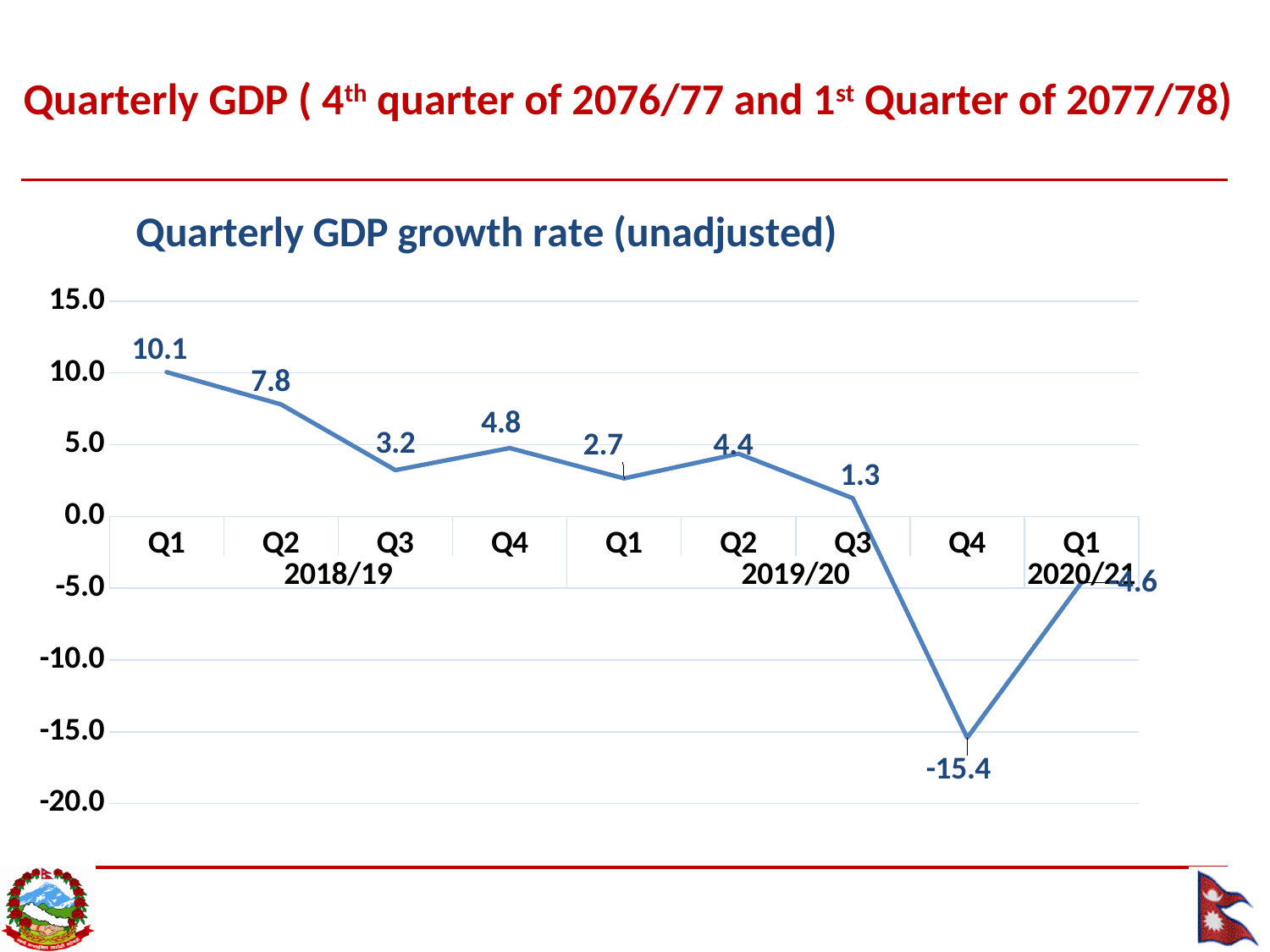
What is the quarterly GDP growth rate for Q3 of 2018/19? 3.2 Which quarter has the highest GDP growth rate? Q1 2018/19 Which quarter has the lowest GDP growth rate? Q4 2019/20 What is the difference between the GDP growth rate in Q1 2018/19 and Q2 2018/19? 2.3 What kind of chart is shown on the slide? line chart What is the quarterly GDP growth rate for Q1 of 2018/19? 10.1 Which is larger, the GDP growth rate in Q4 2018/19 or in Q1 2019/20? Q4 2018/19 What is the quarterly GDP growth rate for Q4 of 2019/20? -15.4 What is the quarterly GDP growth rate for Q2 of 2019/20? 4.4 Is the GDP growth rate for Q1 2020/21 greater or less than 0.0? less How many quarters are plotted on the chart? 9 What is the title of the chart? Quarterly GDP growth rate (unadjusted)